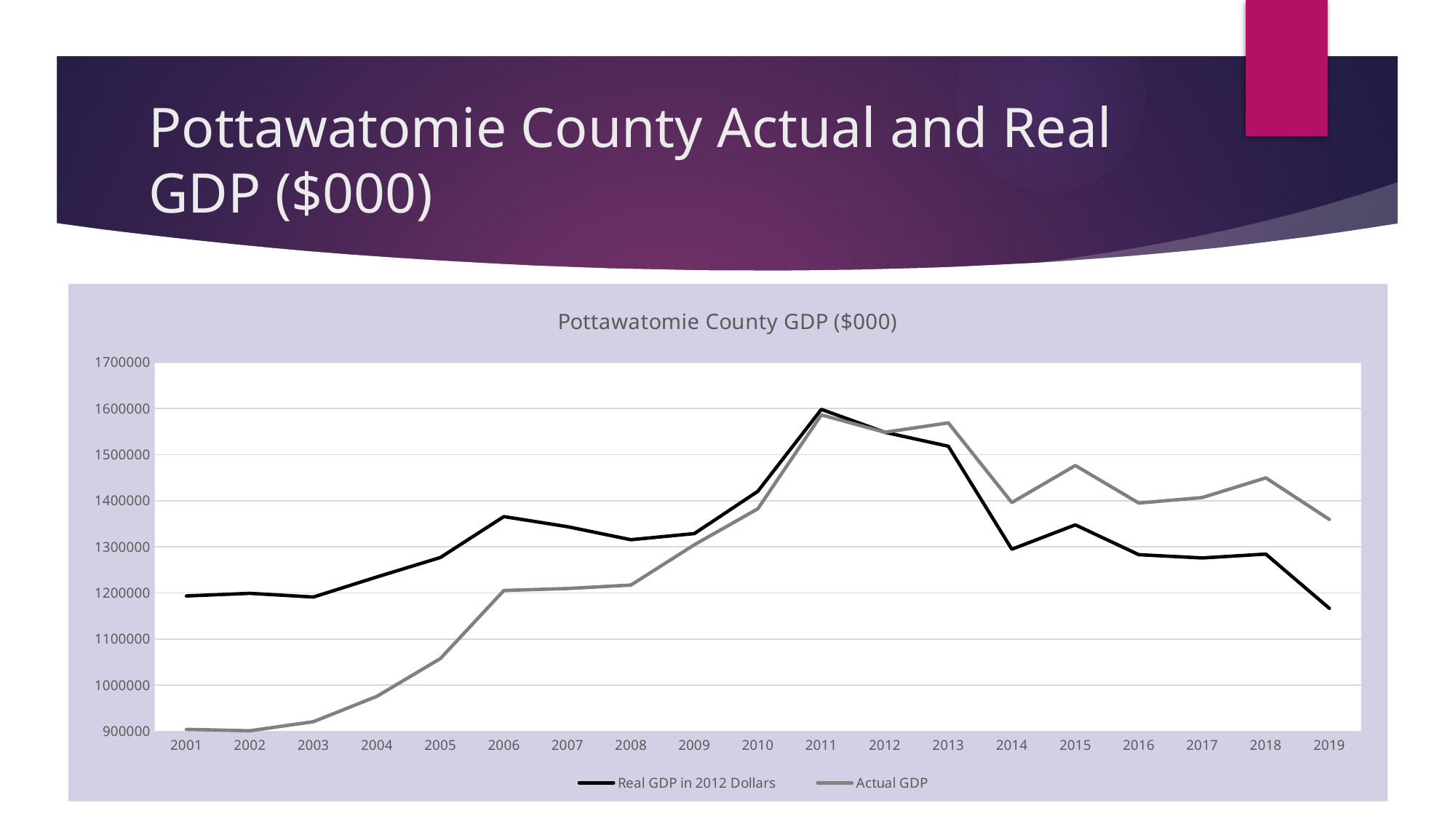
Is the value for Actual GDP in 2001 greater or less than 1000000? less Is the value for Real GDP in 2012 Dollars in 2011 greater or less than 1500000? greater In which year is Real GDP in 2012 Dollars highest? 2011 In 2019, which series has the larger value, Real GDP in 2012 Dollars or Actual GDP? Actual GDP Is the value for Actual GDP in 2015 greater or less than 1400000? greater Does Actual GDP rise or fall from 2001 to 2011? rise In 2001, which series has the larger value, Real GDP in 2012 Dollars or Actual GDP? Real GDP in 2012 Dollars How many years are plotted along the x axis? 19 How many series does the legend list? 2 What kind of chart is shown on the slide? line chart In which year is Real GDP in 2012 Dollars lowest? 2019